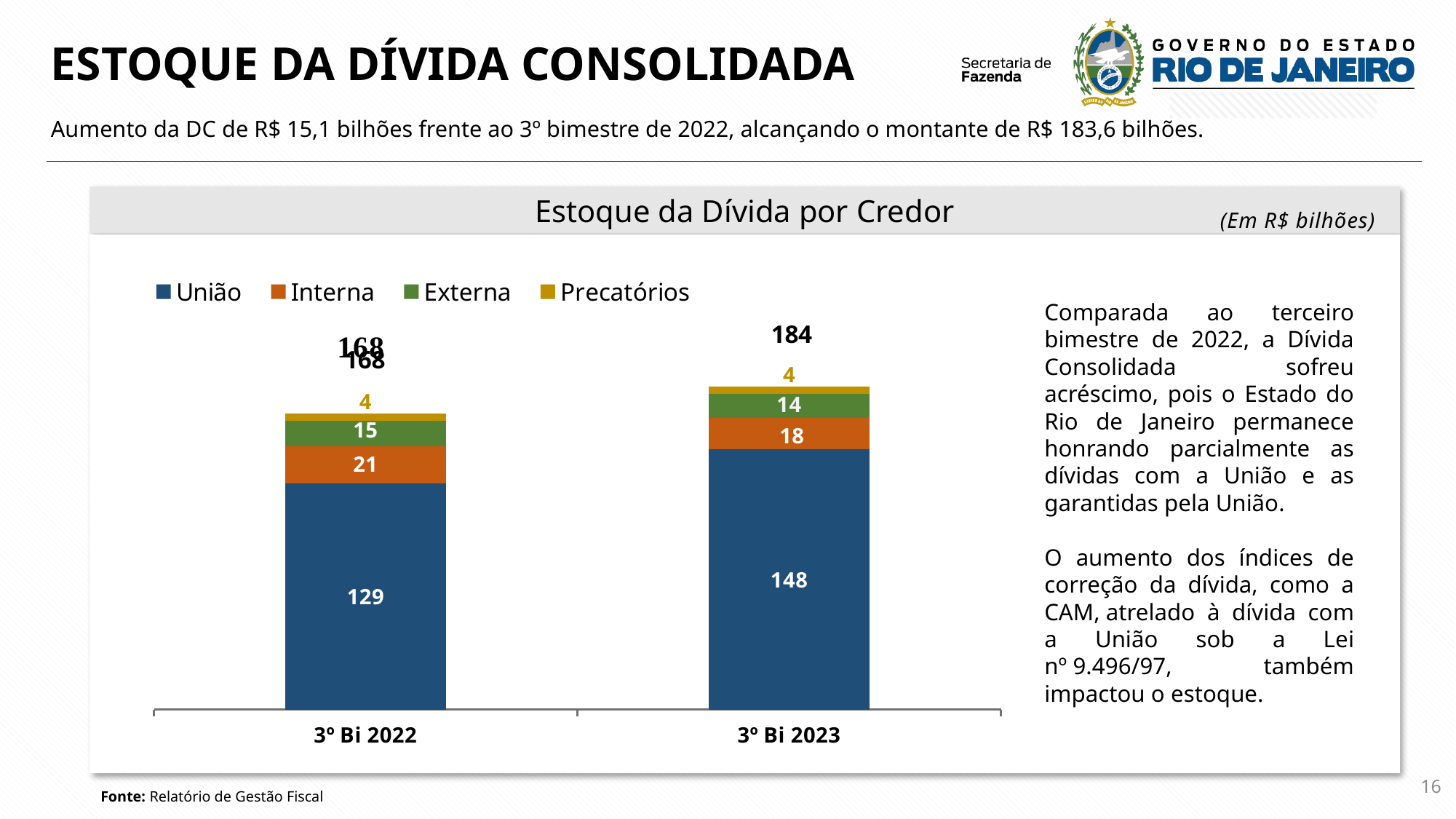
What type of chart is shown on the slide? stacked bar chart What is the value of Externa for 3º Bi 2022? 15 What is the difference between the União values for 3º Bi 2023 and 3º Bi 2022? 19 What is the total of the stacked bar for 3º Bi 2022? 168 How many series does the legend list in the 'Estoque da Dívida por Credor' chart? 4 How many periods (categories) are shown on the x axis of the chart? 2 What is the value of Interna for 3º Bi 2023? 18 What is the value of União for 3º Bi 2022? 129 Which period has the larger Interna value, 3º Bi 2022 or 3º Bi 2023? 3º Bi 2022 What unit is indicated for the values in the chart? R$ bilhões What is the value of União for 3º Bi 2023? 148 What is the total of the stacked bar for 3º Bi 2023? 184